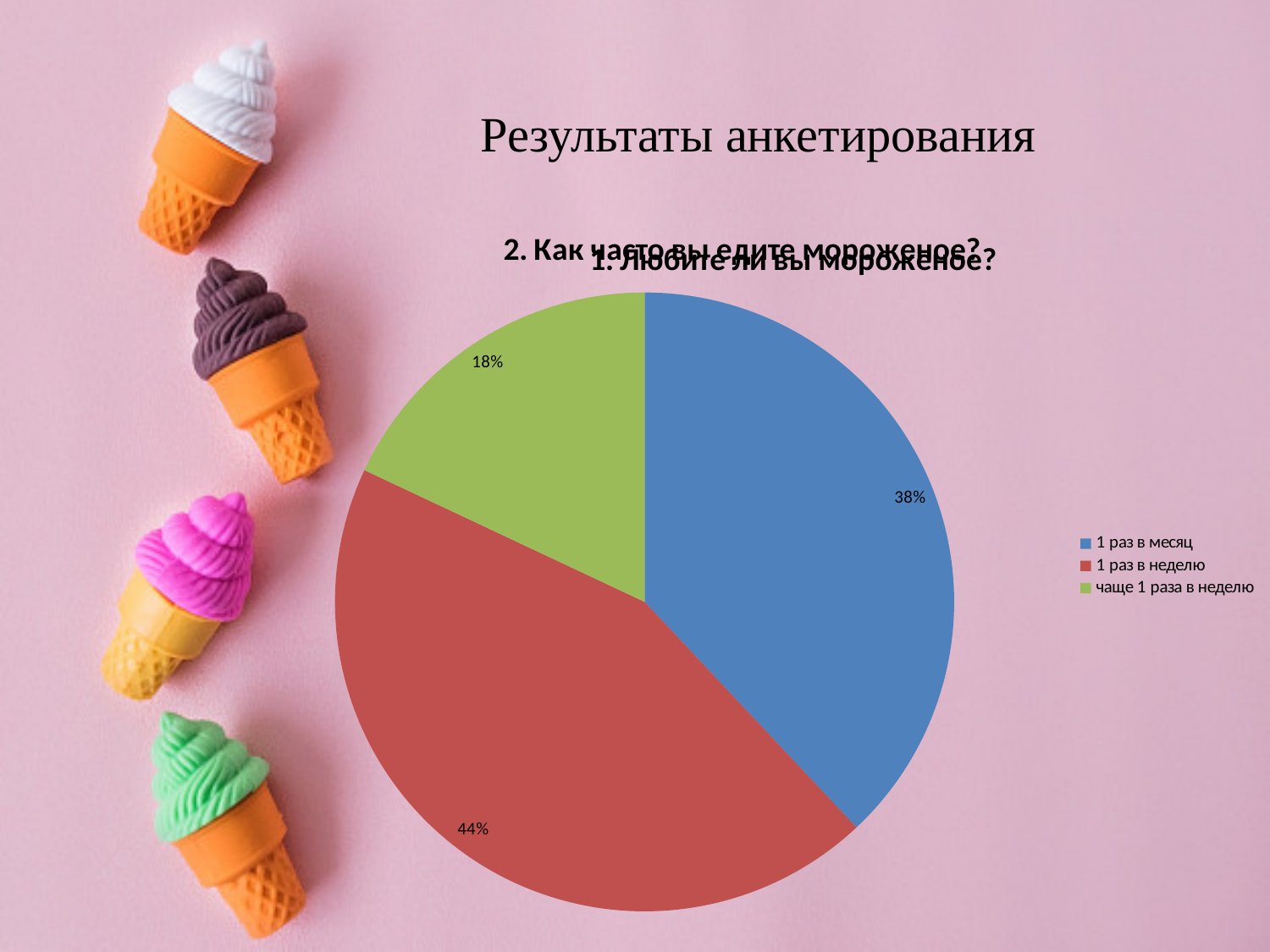
What share of the pie chart is labelled "1 раз в неделю"? 44% Which colour represents "1 раз в неделю" in the pie chart? Red What is the difference in percentage points between the "1 раз в месяц" slice and the "чаще 1 раза в неделю" slice? 20 What share of the pie chart is labelled "1 раз в месяц"? 38% What share of the pie chart is labelled "чаще 1 раза в неделю"? 18% Which slice is larger: "1 раз в месяц" or "чаще 1 раза в неделю"? 1 раз в месяц Which category has the smallest slice of the pie chart? чаще 1 раза в неделю Which category has the largest slice of the pie chart? 1 раз в неделю How many slices does the pie chart have? 3 How many entries does the legend of the pie chart list? 3 What type of chart is shown on the slide? Pie chart What is the difference in percentage points between the "1 раз в неделю" slice and the "1 раз в месяц" slice? 6